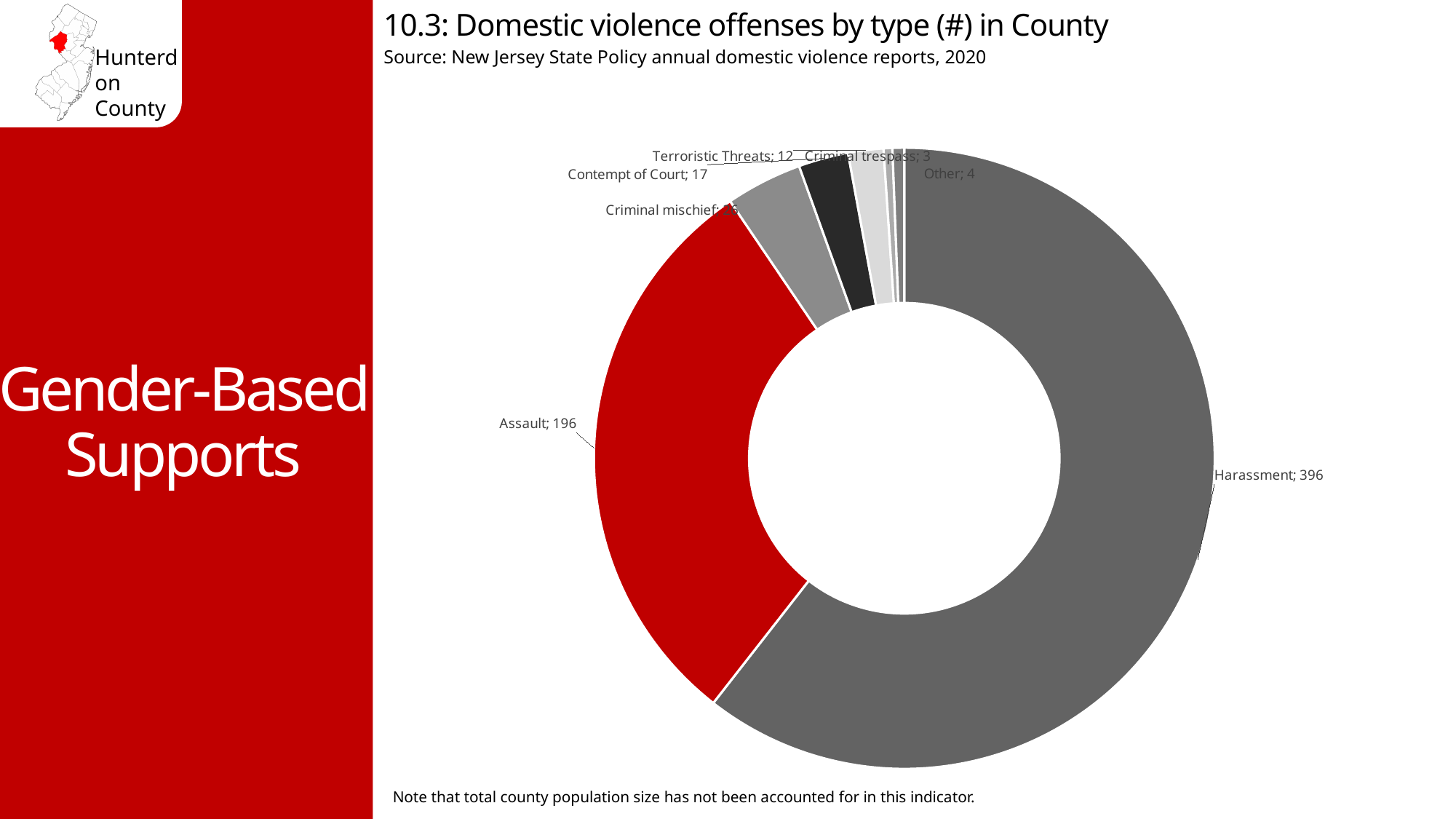
Which offense type has the smallest value on the chart? Criminal trespass What is the value for Terroristic Threats? 12 What is the number of Assault offenses shown on the chart? 196 What kind of chart is shown on the slide? doughnut chart What is the value for Criminal trespass? 3 What is the difference between Contempt of Court and Terroristic Threats? 5 Which is larger, Other or Criminal trespass? Other How many offense categories are shown on the chart? 7 Which offense type has the largest slice of the chart? Harassment What is the difference between the Harassment and Assault values? 200 What is the value for Contempt of Court? 17 What is the number of Harassment offenses shown on the chart? 396